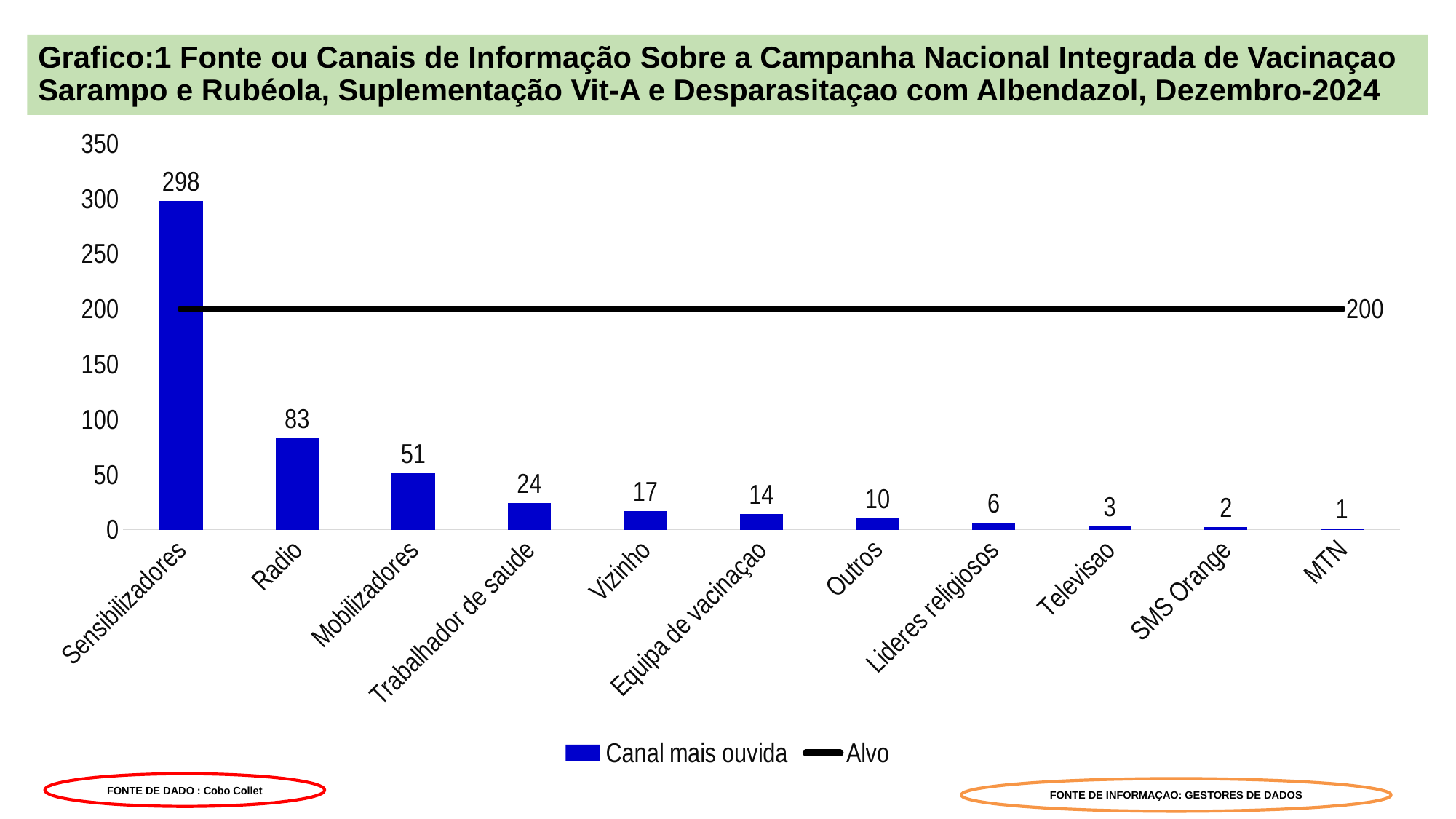
Which category has the lowest value? MTN What is the value of the Alvo line? 200 What is the difference between the values for Sensibilizadores and Radio? 215 What is the value for Sensibilizadores? 298 How many series does the legend list? 2 What is the value for Radio? 83 What kind of chart is this? combination bar and line chart Is the value for Sensibilizadores greater or less than the Alvo line value of 200? greater How many categories are shown on the x axis? 11 Which is larger, the value for Mobilizadores or the value for Vizinho? Mobilizadores What is the value for Trabalhador de saude? 24 Which category has the highest value? Sensibilizadores